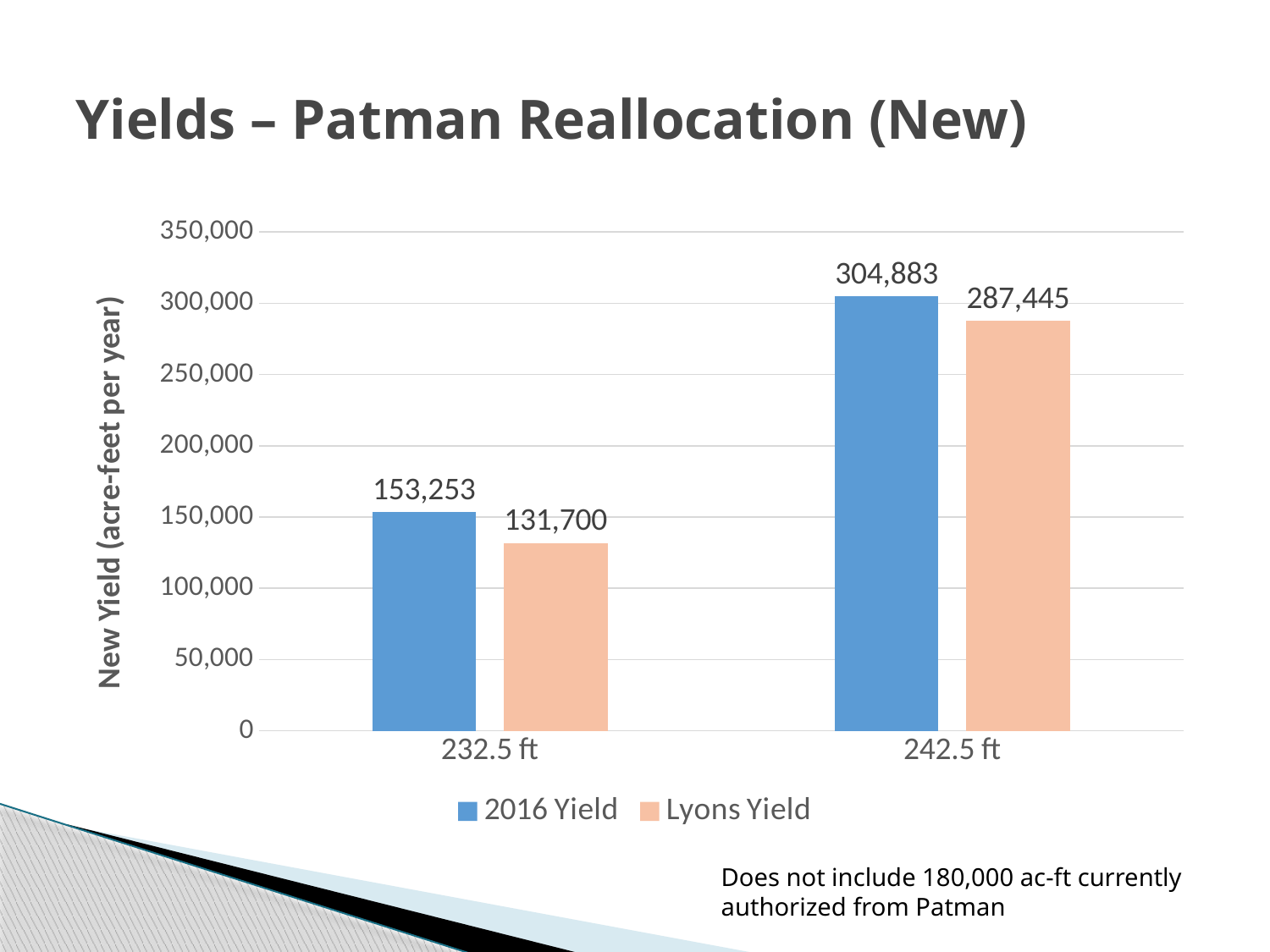
What is the Lyons Yield at 242.5 ft? 287,445 Which bar has the highest value on the chart? 2016 Yield at 242.5 ft Which bar has the lowest value on the chart? Lyons Yield at 232.5 ft What is the difference between the 2016 Yield and the Lyons Yield at 242.5 ft? 17,438 What is the label of the vertical axis? New Yield (acre-feet per year) What is the 2016 Yield at 242.5 ft? 304,883 What is the difference between the 2016 Yield and the Lyons Yield at 232.5 ft? 21,553 How many series does the legend list? 2 What type of chart is shown on the slide? Bar chart At 232.5 ft, which is larger: the 2016 Yield or the Lyons Yield? 2016 Yield What is the Lyons Yield at 232.5 ft? 131,700 What is the 2016 Yield at 232.5 ft? 153,253